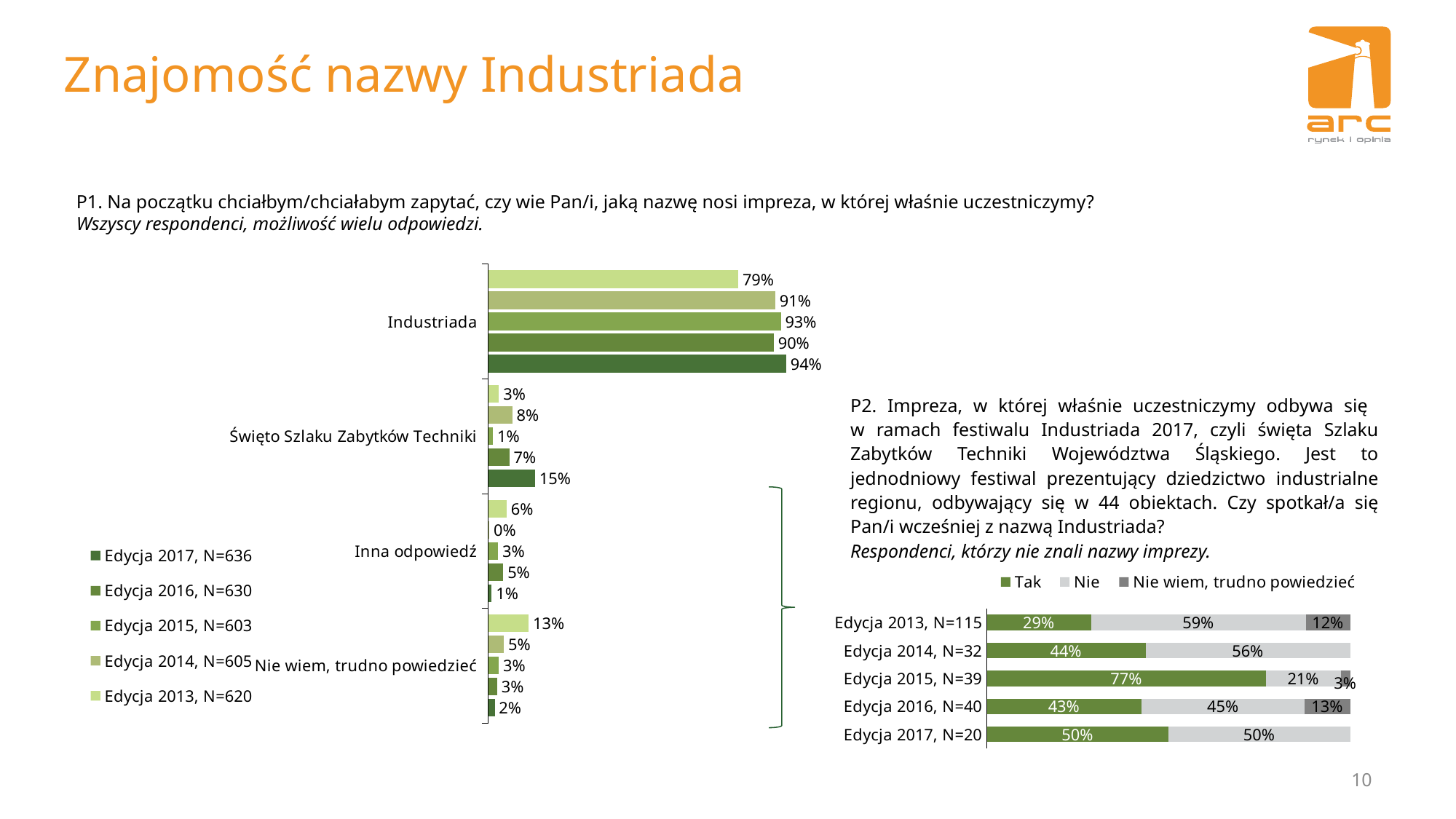
In the left chart (P1), how many answer categories are shown? 4 In the left chart (P1), which edition has the highest value for "Industriada"? Edycja 2017, N=636 In the right chart (P2), which edition has the highest share of "Tak" answers? Edycja 2015, N=39 In the right chart (P2), is the "Nie" value for Edycja 2013, N=115 larger or smaller than the "Nie" value for Edycja 2017, N=20? larger In the left chart (P1), which edition has the lowest value for "Industriada"? Edycja 2013, N=620 In the left chart (P1), what percentage of respondents in Edycja 2017 answered "Industriada"? 94% In the right chart (P2), what percentage of Edycja 2015, N=39 answered "Tak"? 77% In the left chart (P1), what is the difference between the Edycja 2017 and Edycja 2013 values for "Industriada"? 15% In the left chart (P1), what percentage of respondents in Edycja 2013 answered "Nie wiem, trudno powiedzieć"? 13% In the left chart (P1), how many series does the legend list? 5 In the right chart (P2), what is the total of the Edycja 2016, N=40 bar? 101% What type of chart is the right chart (P2)? Stacked bar chart